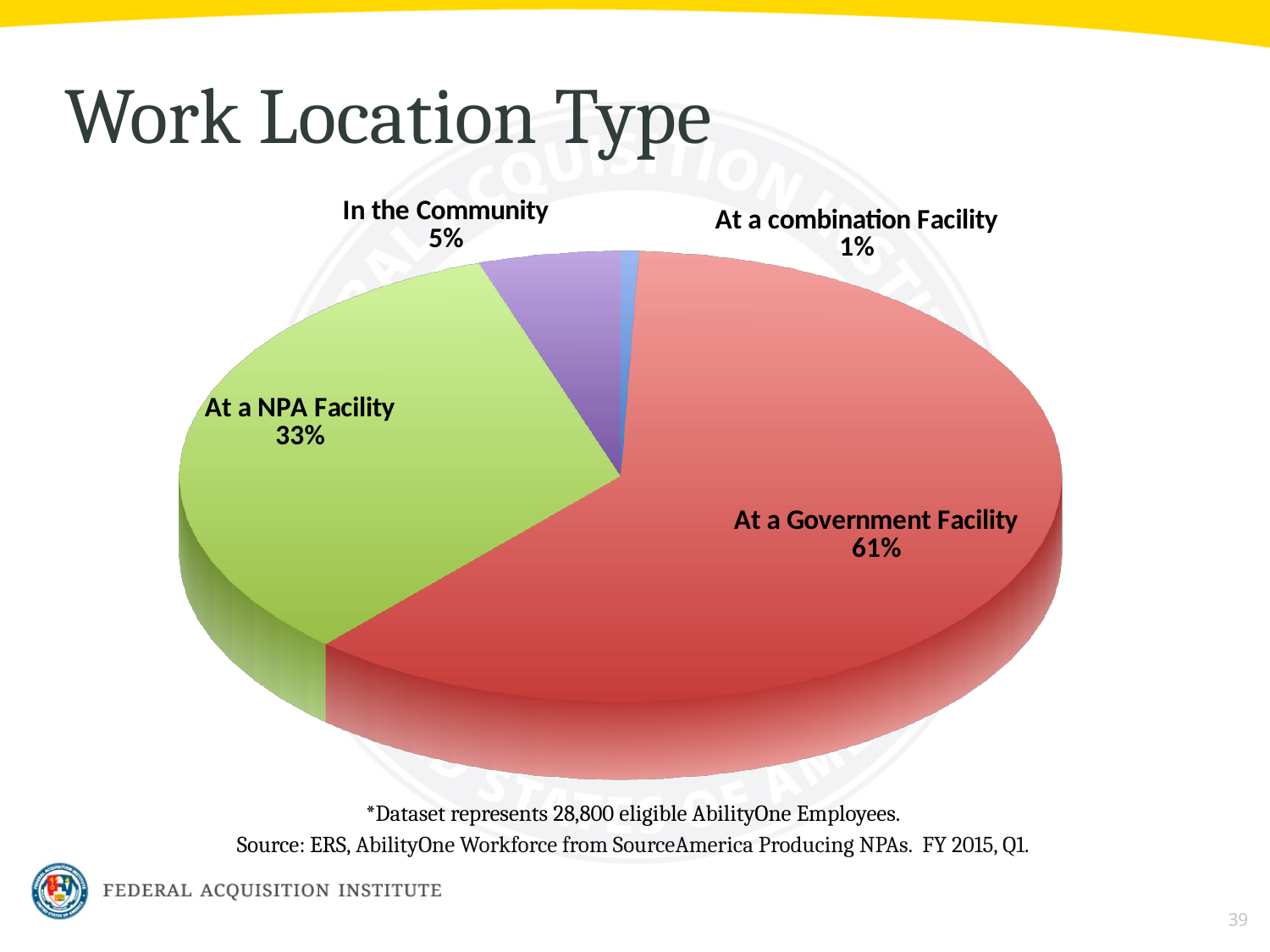
What type of chart is shown on the slide? Pie chart What percentage of employees work at a combination Facility? 1% What percentage of employees work in the Community? 5% What is the difference in percentage points between At a Government Facility and At a NPA Facility? 28 Which work location type has the largest share? At a Government Facility Which is larger: the share for In the Community or the share for At a combination Facility? In the Community How many work location types are shown in the pie chart? 4 What percentage of employees work at a NPA Facility? 33% What is the title of the chart on the slide? Work Location Type Which work location type has the smallest share? At a combination Facility What colour is the slice for At a NPA Facility? Green What percentage of employees work at a Government Facility? 61%